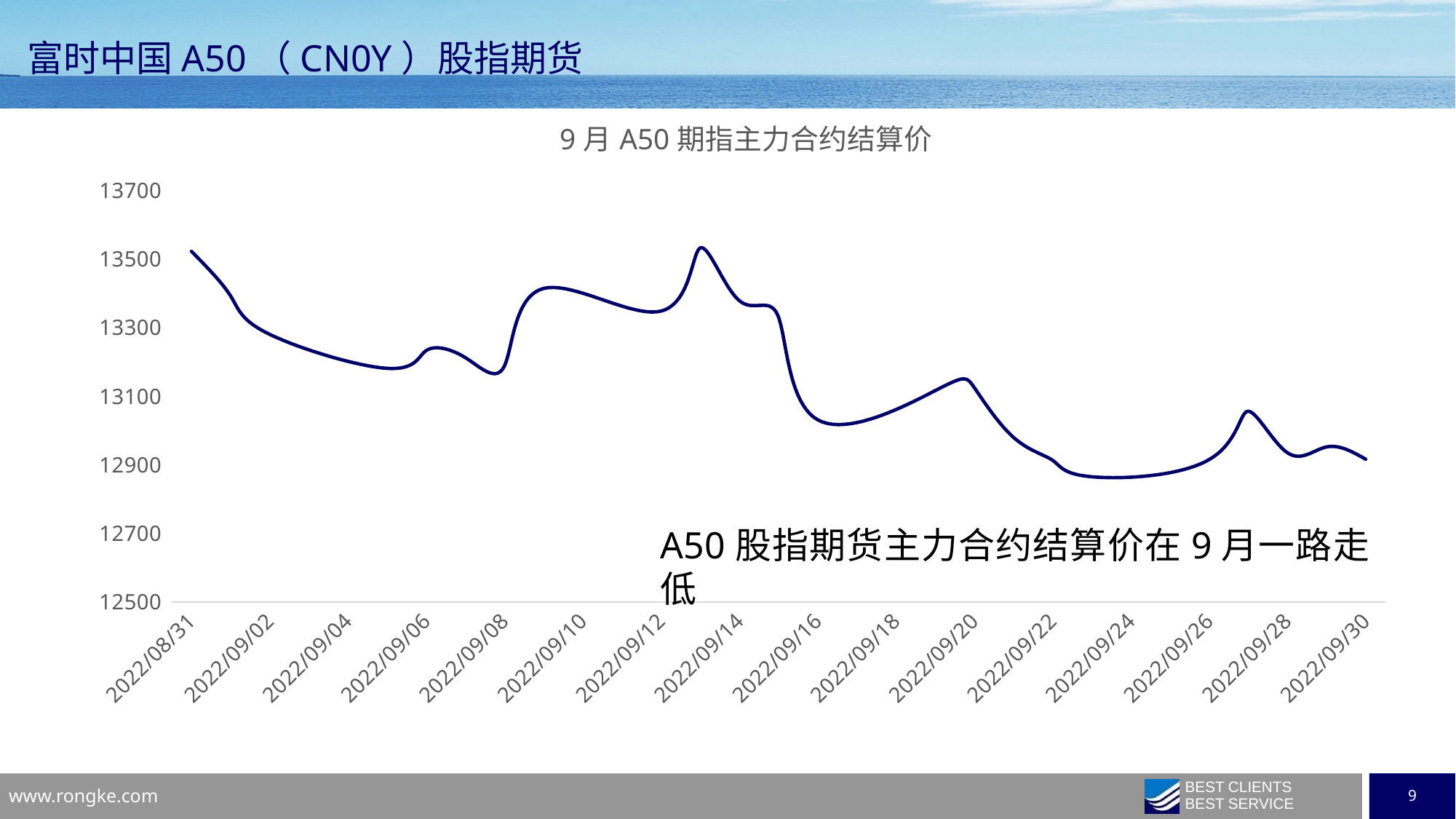
Which is larger, the value for 2022/09/10 or the value for 2022/09/18? 2022/09/10 How many date labels are shown on the x axis? 16 Is the value for 2022/09/24 greater or less than 12900? less What kind of chart is shown on the slide? line chart What is the title of the chart? 9月A50期指主力合约结算价 Overall, do the values rise or fall from 2022/08/31 to 2022/09/30? fall Is the value for 2022/09/26 greater or less than 13100? less Is the value for 2022/09/16 greater or less than 13100? less What is the highest tick value shown on the y axis? 13700 Which is larger, the value for 2022/08/31 or the value for 2022/09/30? 2022/08/31